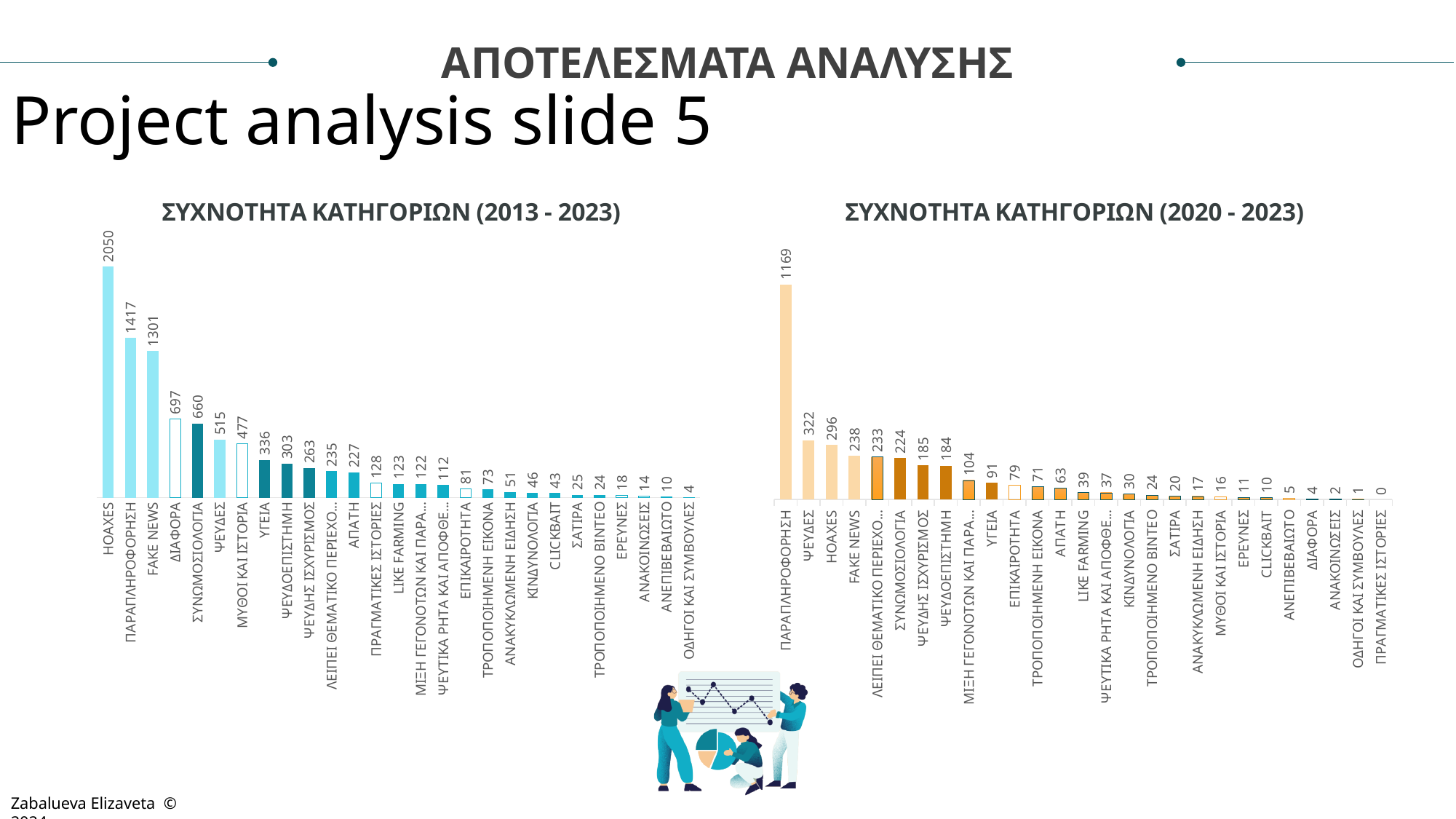
In the chart titled ΣΥΧΝΟΤΗΤΑ ΚΑΤΗΓΟΡΙΩΝ (2020 - 2023), what is the difference between the values for ΨΕΥΔΕΣ and HOAXES? 26 In the chart titled ΣΥΧΝΟΤΗΤΑ ΚΑΤΗΓΟΡΙΩΝ (2013 - 2023), which category has the lowest value? ΟΔΗΓΟΙ ΚΑΙ ΣΥΜΒΟΥΛΕΣ In the chart titled ΣΥΧΝΟΤΗΤΑ ΚΑΤΗΓΟΡΙΩΝ (2013 - 2023), what is the value for HOAXES? 2050 In the chart titled ΣΥΧΝΟΤΗΤΑ ΚΑΤΗΓΟΡΙΩΝ (2013 - 2023), what is the value for ΣΥΝΩΜΟΣΙΟΛΟΓΙΑ? 660 What kind of chart is the chart titled ΣΥΧΝΟΤΗΤΑ ΚΑΤΗΓΟΡΙΩΝ (2020 - 2023)? Bar chart In the chart titled ΣΥΧΝΟΤΗΤΑ ΚΑΤΗΓΟΡΙΩΝ (2013 - 2023), do the values rise or fall from left to right along the x axis? Fall In the chart titled ΣΥΧΝΟΤΗΤΑ ΚΑΤΗΓΟΡΙΩΝ (2020 - 2023), what is the value for ΠΑΡΑΠΛΗΡΟΦΟΡΗΣΗ? 1169 In the chart titled ΣΥΧΝΟΤΗΤΑ ΚΑΤΗΓΟΡΙΩΝ (2013 - 2023), which is larger, ΥΓΕΙΑ or ΑΠΑΤΗ? ΥΓΕΙΑ In the chart titled ΣΥΧΝΟΤΗΤΑ ΚΑΤΗΓΟΡΙΩΝ (2020 - 2023), what is the value for CLICKBAIT? 10 In the chart titled ΣΥΧΝΟΤΗΤΑ ΚΑΤΗΓΟΡΙΩΝ (2020 - 2023), which is larger, ΥΓΕΙΑ or ΑΠΑΤΗ? ΥΓΕΙΑ In the chart titled ΣΥΧΝΟΤΗΤΑ ΚΑΤΗΓΟΡΙΩΝ (2013 - 2023), what is the difference between the values for ΠΑΡΑΠΛΗΡΟΦΟΡΗΣΗ and FAKE NEWS? 116 In the chart titled ΣΥΧΝΟΤΗΤΑ ΚΑΤΗΓΟΡΙΩΝ (2020 - 2023), which category has the highest value? ΠΑΡΑΠΛΗΡΟΦΟΡΗΣΗ